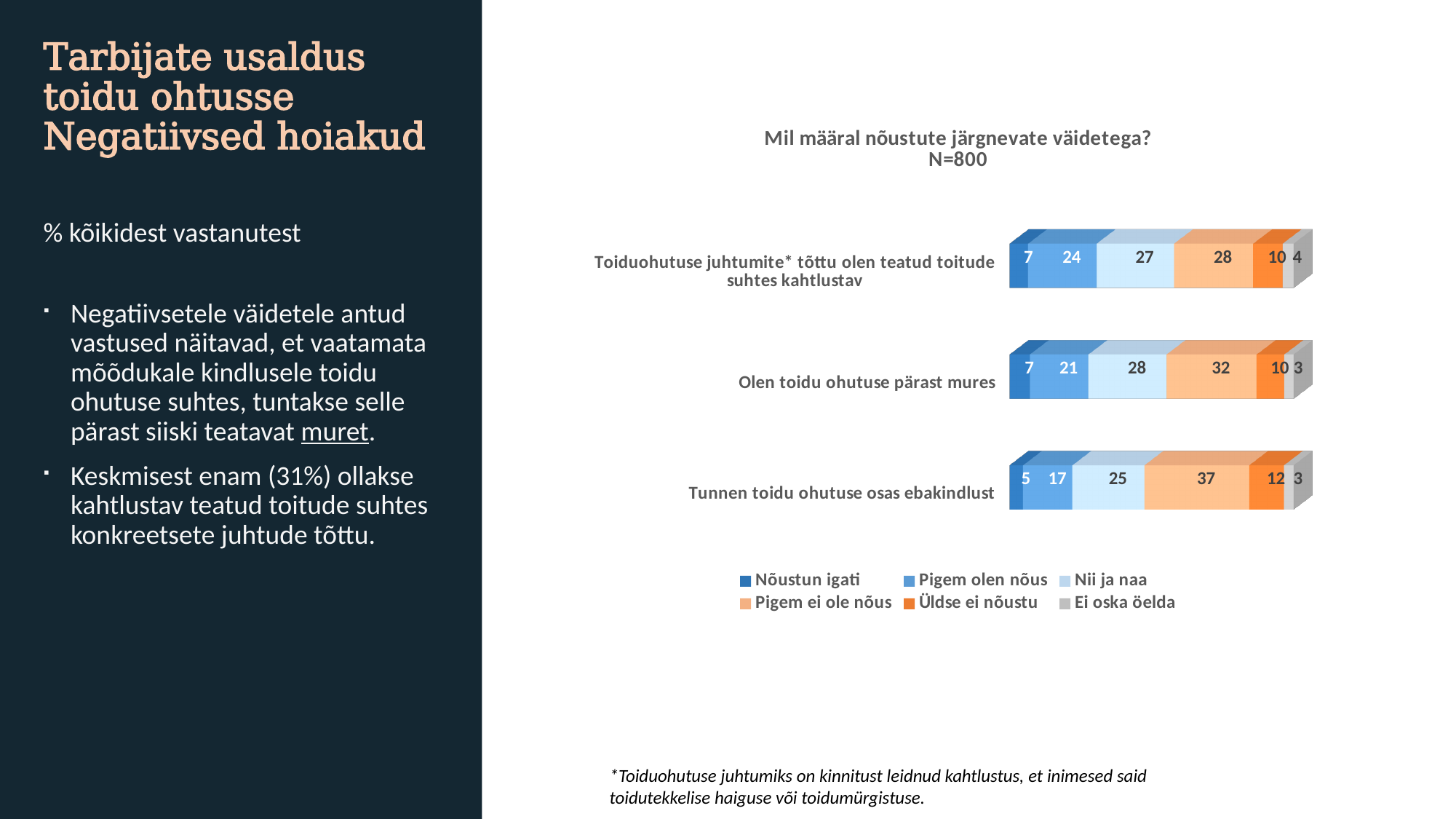
What is the value of "Üldse ei nõustu" for "Tunnen toidu ohutuse osas ebakindlust"? 12 How many statements (categories) are plotted in the chart? 3 What is the value of "Pigem olen nõus" for "Toiduohutuse juhtumite* tõttu olen teatud toitude suhtes kahtlustav"? 24 What is the value of "Pigem ei ole nõus" for "Tunnen toidu ohutuse osas ebakindlust"? 37 Which statement has the lowest value for "Nõustun igati"? Tunnen toidu ohutuse osas ebakindlust Which is larger: "Pigem olen nõus" for "Olen toidu ohutuse pärast mures" or "Pigem olen nõus" for "Tunnen toidu ohutuse osas ebakindlust"? Olen toidu ohutuse pärast mures What is the value of "Nii ja naa" for "Olen toidu ohutuse pärast mures"? 28 What is the sample size (N) stated in the chart title? N=800 What kind of chart is shown on the slide? Stacked bar chart Which statement has the highest value for "Pigem ei ole nõus"? Tunnen toidu ohutuse osas ebakindlust How many series does the legend list? 6 What is the difference between the "Pigem ei ole nõus" values for "Tunnen toidu ohutuse osas ebakindlust" and "Olen toidu ohutuse pärast mures"? 5